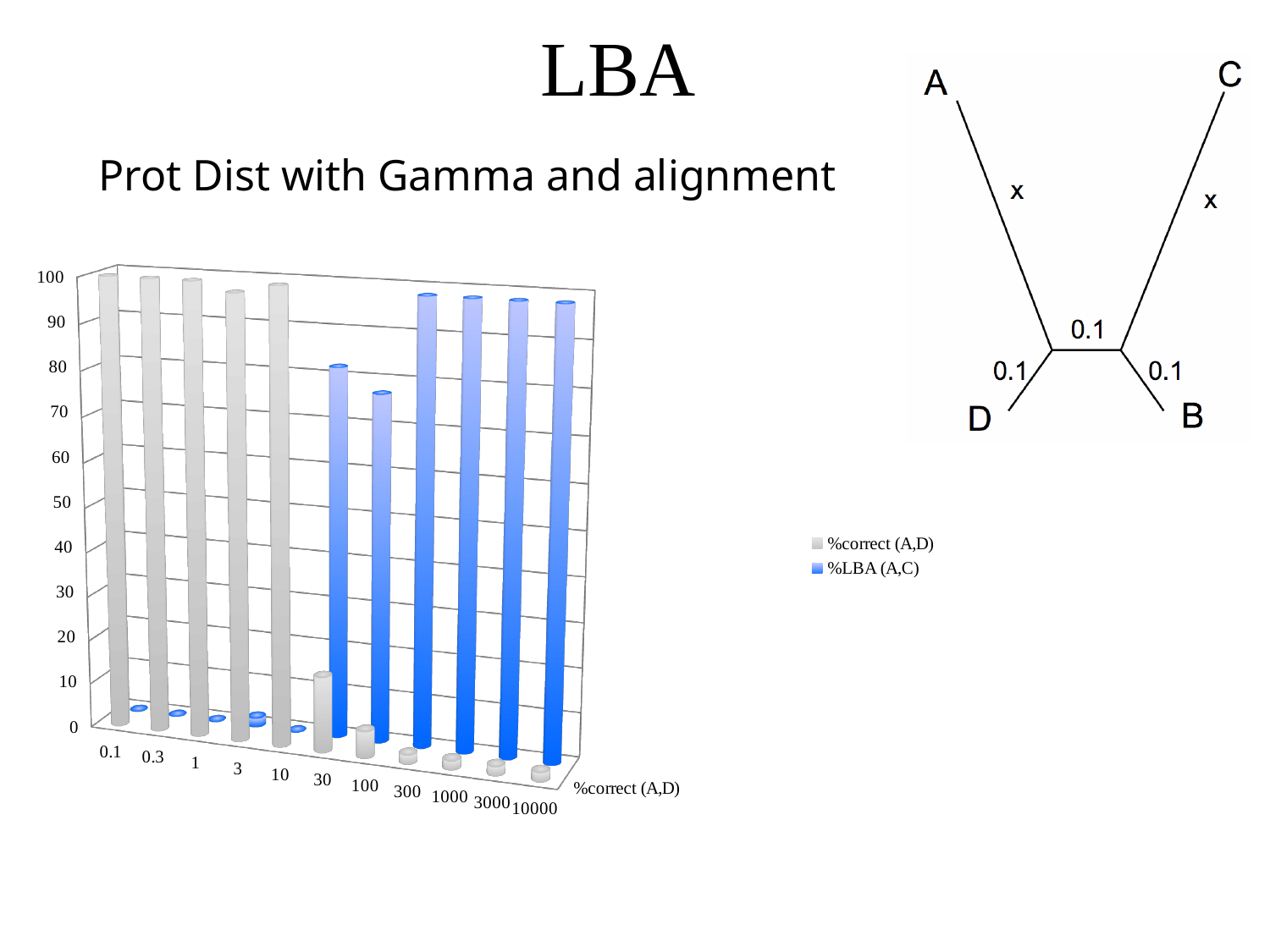
At category 1000, which series has the larger value, %correct (A,D) or %LBA (A,C)? %LBA (A,C) Is the value of %LBA (A,C) at 10000 greater or less than 90? greater Is the value of %LBA (A,C) at 30 greater or less than 70? greater What kind of chart is shown on the slide? bar chart Do the values of the %correct (A,D) series rise or fall as you move along the x axis from 0.1 to 10000? fall How many series does the chart's legend list? 2 What colour are the bars for the %LBA (A,C) series? blue How many categories are shown along the x axis of the chart? 11 What are the two series named in the chart's legend? %correct (A,D) and %LBA (A,C) Is the value of %correct (A,D) at 10000 greater or less than 10? less